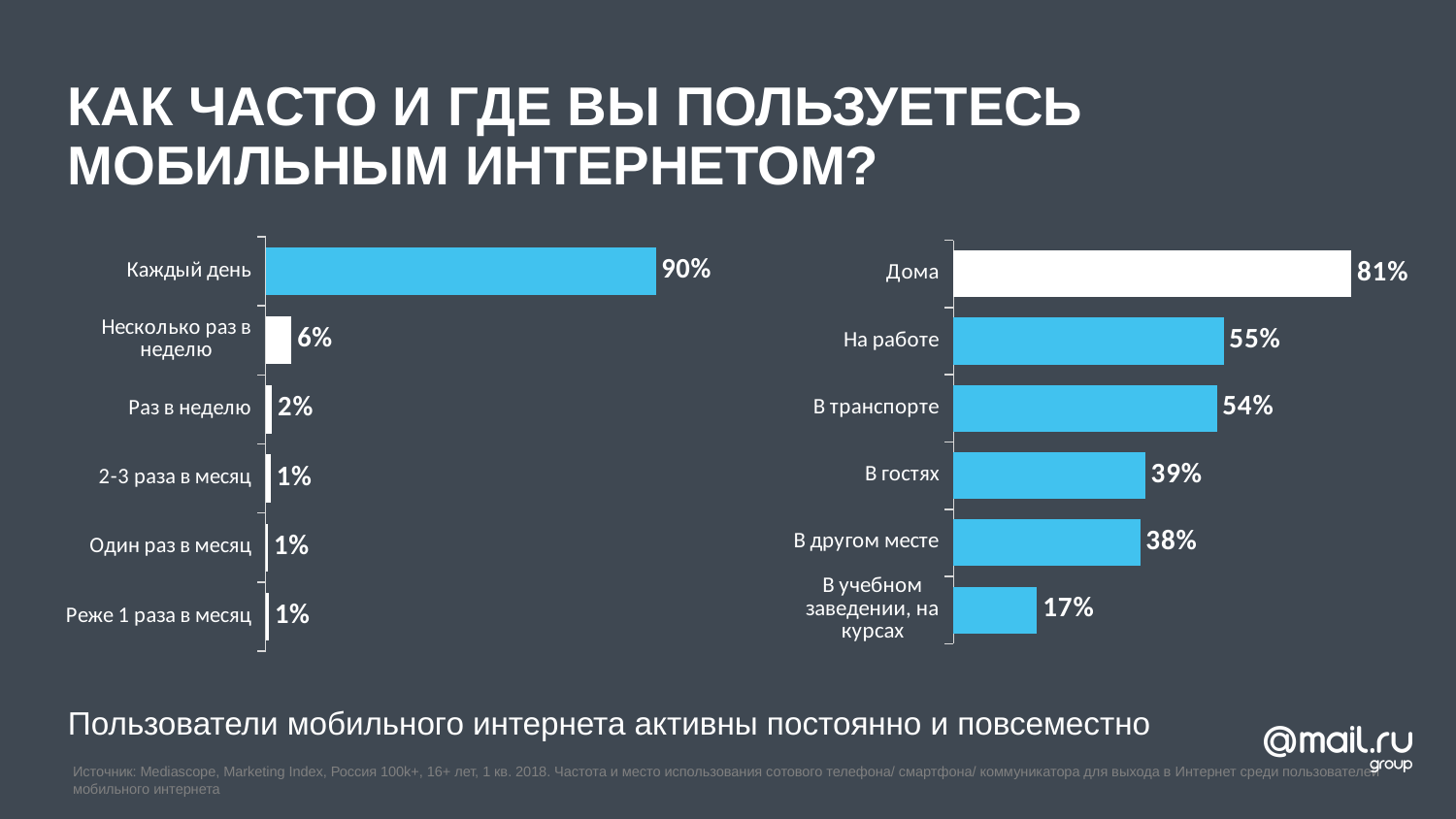
What kind of chart is the right chart? Bar chart In the right chart, which category has the lowest value? В учебном заведении, на курсах In the right chart, which is larger: "В гостях" or "В учебном заведении, на курсах"? В гостях In the right chart, what is the difference between "Дома" and "На работе"? 26% In the right chart, which category has the highest value? Дома In the right chart, what is the value for "В транспорте"? 54% In the left chart, what is the value for "Каждый день"? 90% In the left chart, which category has the highest value? Каждый день In the right chart, what is the value for "В учебном заведении, на курсах"? 17% How many categories does the left chart show? 6 In the right chart, which bar is coloured white instead of blue? Дома In the left chart, what is the difference between "Несколько раз в неделю" and "Раз в неделю"? 4%